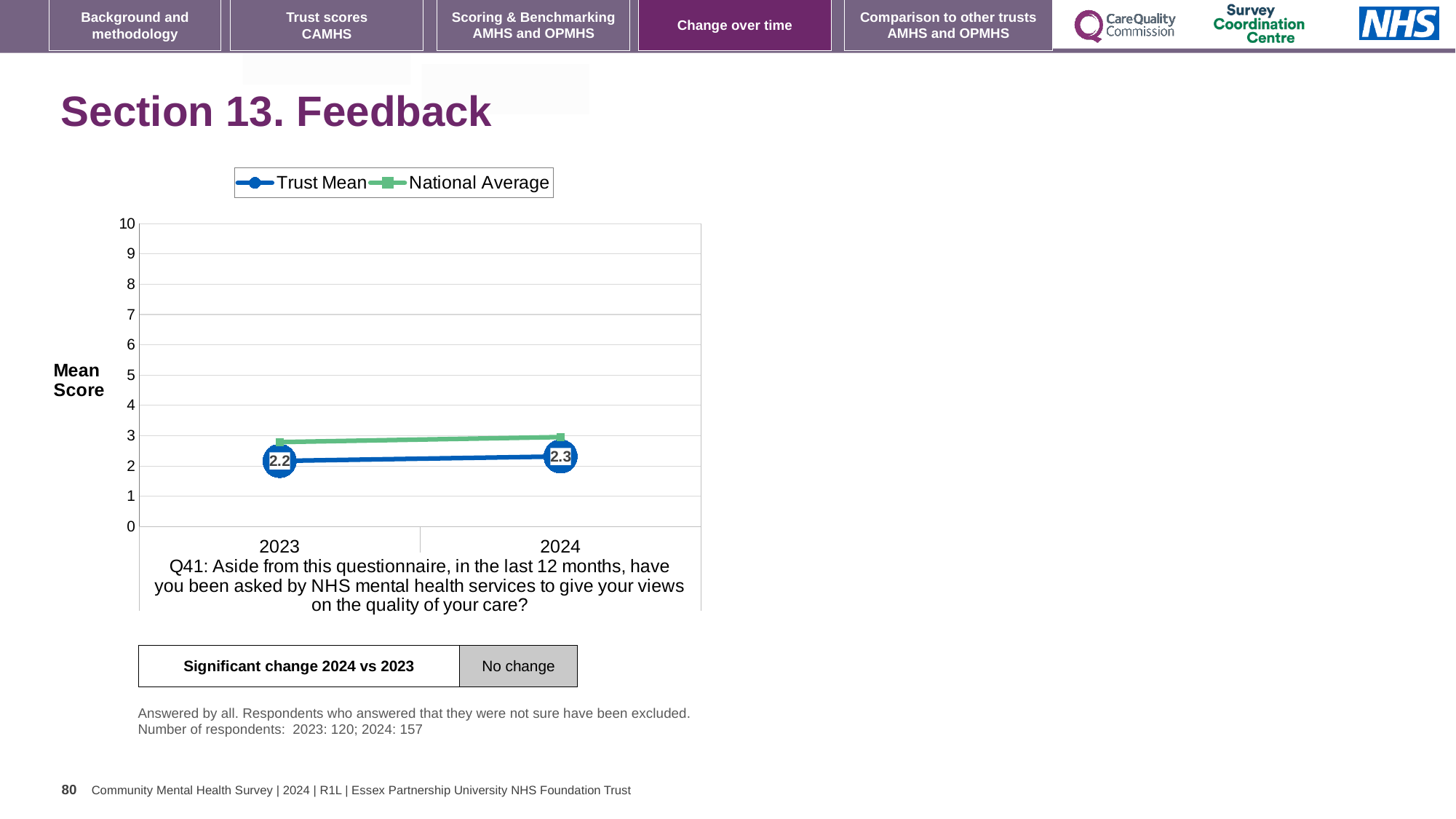
Is the National Average value for 2023 greater or less than 4? less In 2024, which series is higher, Trust Mean or National Average? National Average What is the Trust Mean score for 2023? 2.2 What is the label on the y axis of the chart? Mean Score By how much did the Trust Mean change from 2023 to 2024? 0.1 What kind of chart is shown on the slide? Line chart How many years are plotted on the x axis? 2 Does the Trust Mean rise or fall from 2023 to 2024? Rise Is the National Average value for 2024 greater or less than 2? greater What is the Trust Mean score for 2024? 2.3 Which year has the higher Trust Mean score, 2023 or 2024? 2024 How many series does the legend list? 2